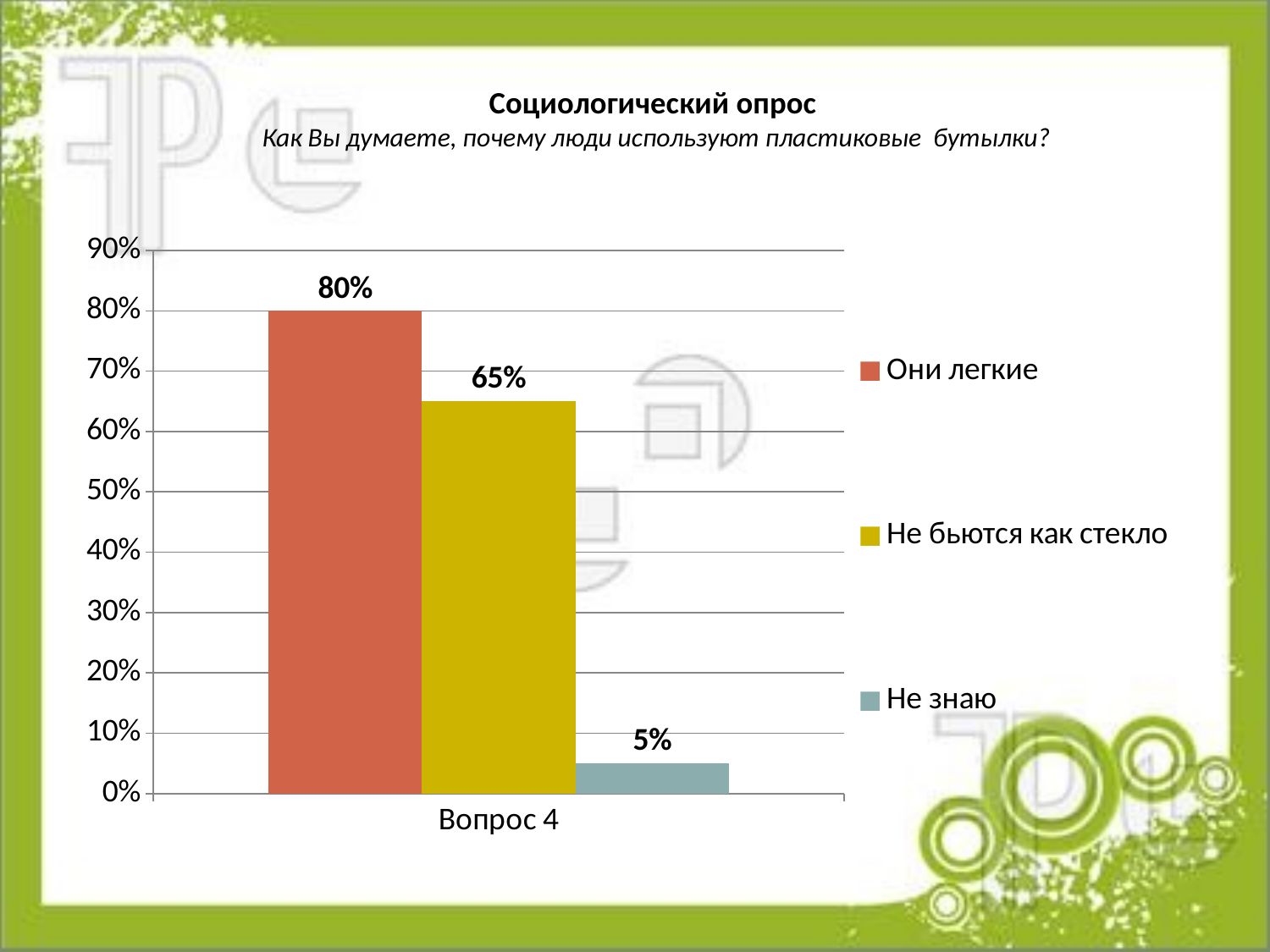
What is the label on the x axis under the bars? Вопрос 4 Which series has the lowest value? Не знаю What is the difference between the values for "Не бьются как стекло" and "Не знаю"? 60% What kind of chart is shown on the slide? bar chart Which is larger, the value for "Они легкие" or the value for "Не бьются как стекло"? Они легкие What is the value for "Не знаю"? 5% What is the difference between the values for "Они легкие" and "Не бьются как стекло"? 15% Which series has the highest value? Они легкие How many series does the legend list? 3 Is the value for "Не знаю" greater or less than 10%? less What is the value for "Не бьются как стекло"? 65% What is the value for "Они легкие"? 80%